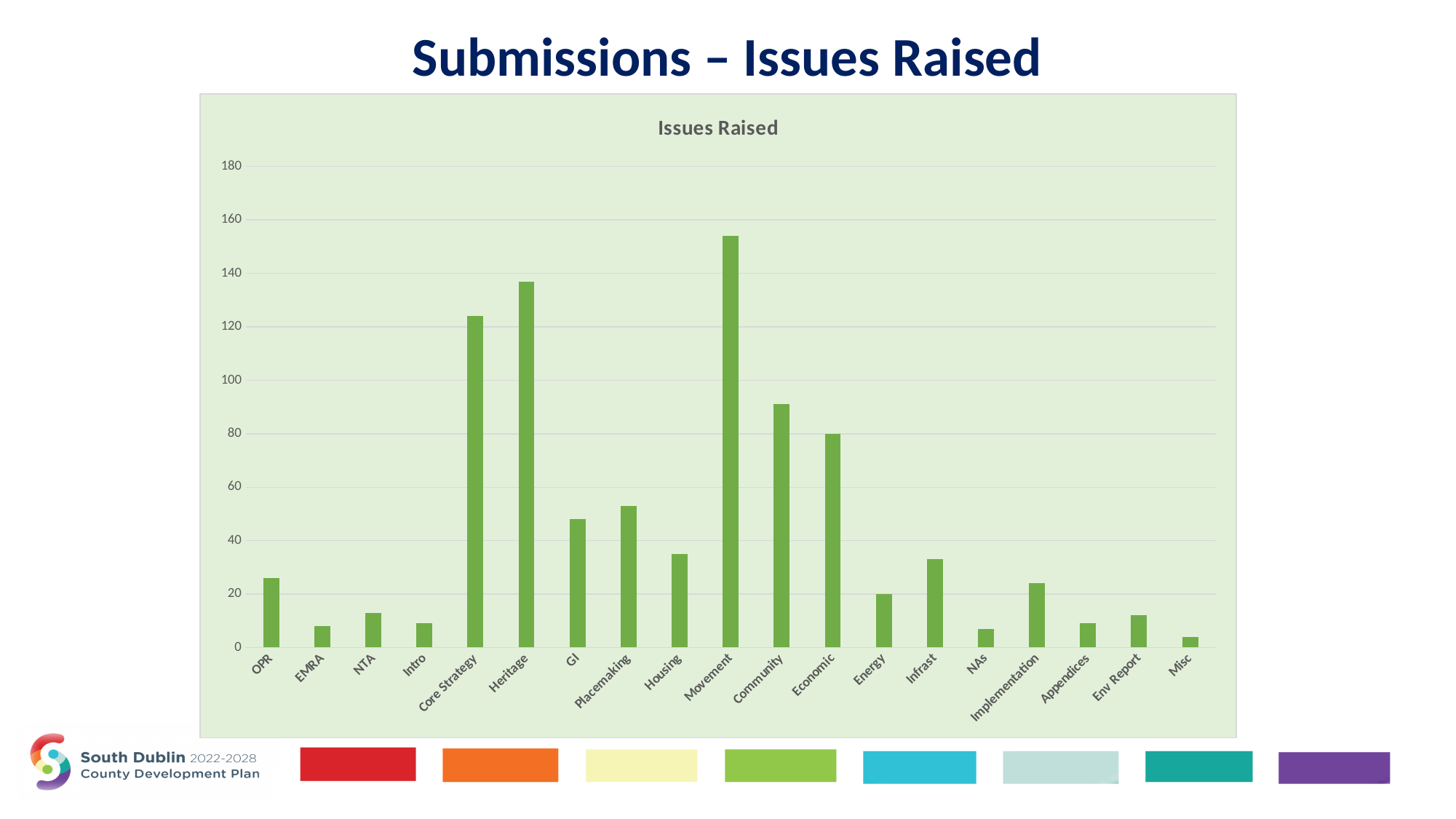
Is the value for Housing greater or less than 40? less Is the value for Infrast greater or less than 20? greater Which has more issues raised, Heritage or Core Strategy? Heritage What is the title of the chart? Issues Raised Which category has the lowest number of issues raised? Misc Is the value for Community greater or less than 100? less How many categories are shown on the x axis of the chart? 19 Which has more issues raised, Community or Economic? Community What kind of chart is shown on the slide? bar chart Which category has the highest number of issues raised? Movement